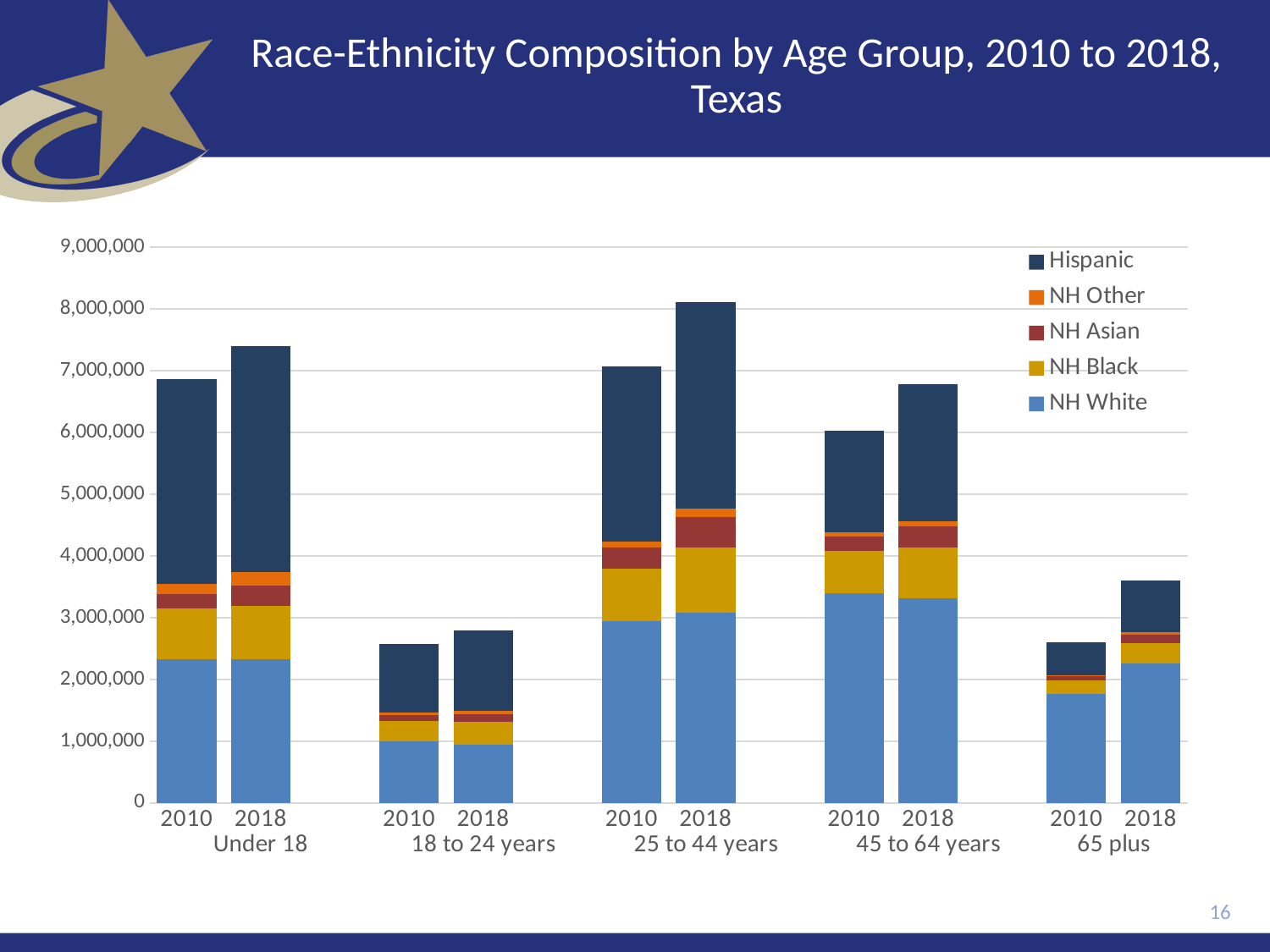
Is the total for 25 to 44 years in 2018 greater or less than 7,000,000? greater How many age groups are shown along the x axis? 5 Is the total for 65 plus in 2018 greater or less than 4,000,000? less Which is larger in 2018: the total for Under 18 or the total for 45 to 64 years? Under 18 Is the total for 18 to 24 years in 2010 greater or less than 3,000,000? less What kind of chart is shown on the slide? Stacked bar chart Within each age group, does the total population rise or fall from 2010 to 2018? Rise Which series is listed first in the legend? Hispanic How many series does the legend list? 5 How many bars are plotted in total on the chart? 10 Which bar has the highest total population? 25 to 44 years, 2018